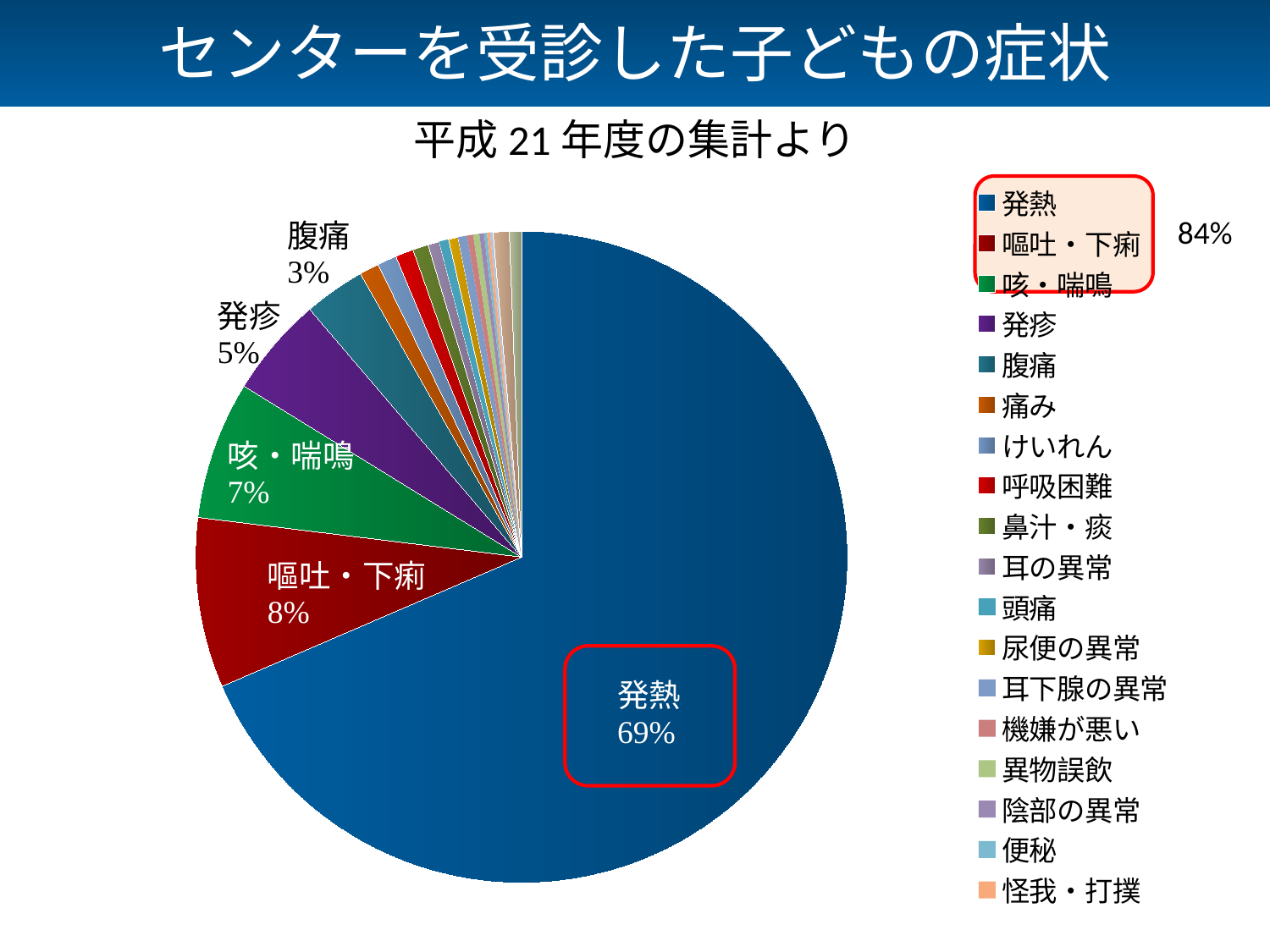
What share of the pie does 発熱 account for? 69% What percentage is shown for 嘔吐・下痢? 8% What percentage is shown for 咳・喘鳴? 7% What is the combined percentage of 咳・喘鳴 and 腹痛? 10% Which category has the largest slice of the pie? 発熱 What is the difference in percentage points between 発熱 and 嘔吐・下痢? 61 What percentage is shown for 発疹? 5% What kind of chart is shown on the slide? pie chart How many categories does the legend list? 18 What percentage is shown for 腹痛? 3% What combined percentage is annotated next to the three highlighted legend entries (発熱, 嘔吐・下痢, 咳・喘鳴)? 84% Which is larger, the slice for 嘔吐・下痢 or the slice for 発疹? 嘔吐・下痢